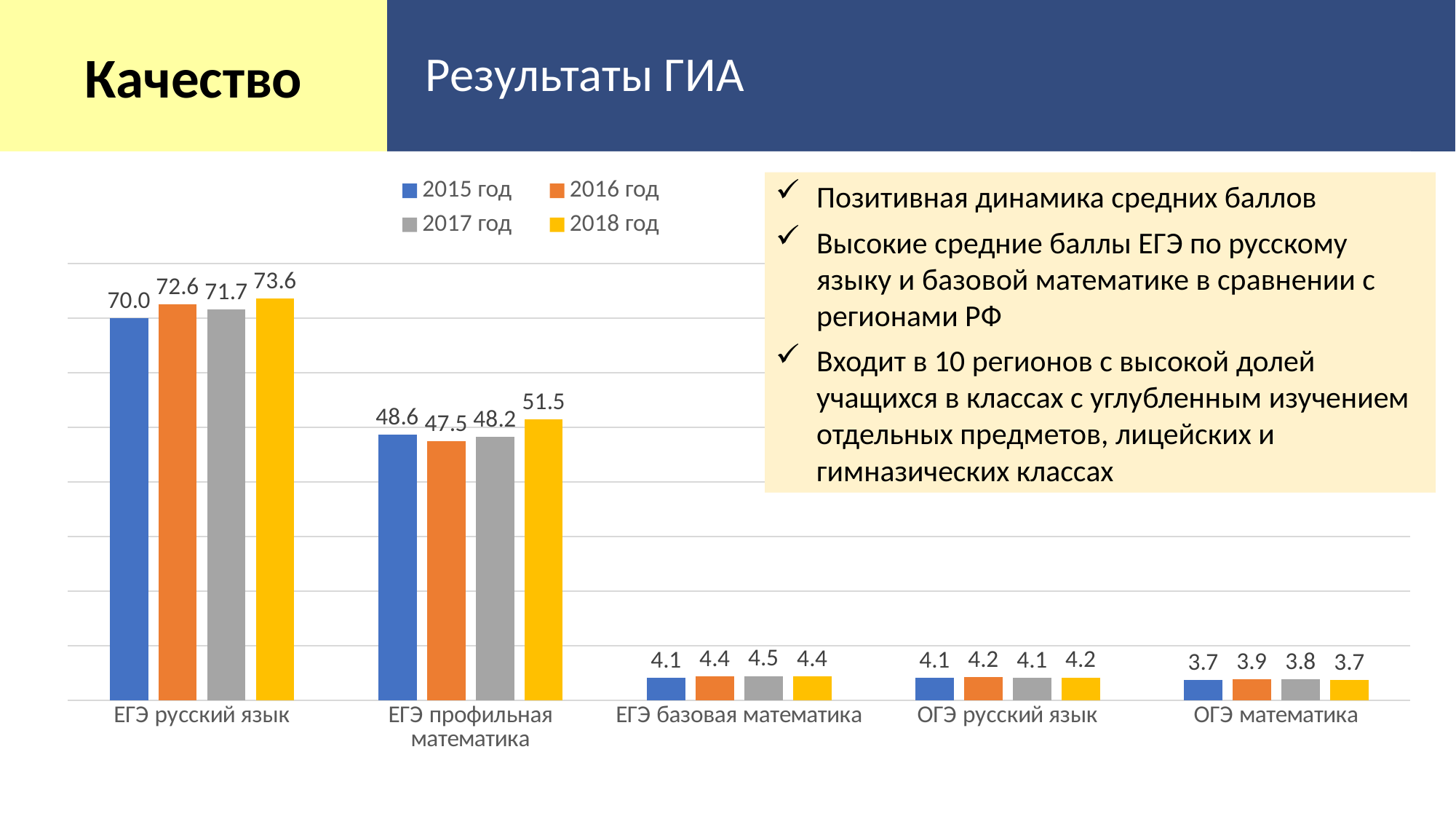
What is the difference between the 2018 год and 2015 год values for ЕГЭ русский язык? 3.6 What is the value for ЕГЭ базовая математика in 2015 год? 4.1 Which is larger for ЕГЭ профильная математика: the 2015 год value or the 2016 год value? 2015 год What is the difference between the 2018 год and 2017 год values for ЕГЭ профильная математика? 3.3 Which year has the highest value for ЕГЭ профильная математика? 2018 год How many series does the legend list? 4 Which year has the lowest value for ЕГЭ русский язык? 2015 год What kind of chart is shown on the slide? bar chart How many categories are shown on the x axis? 5 What is the value for ЕГЭ русский язык in 2018 год? 73.6 What is the value for ОГЭ математика in 2017 год? 3.8 What is the value for ЕГЭ профильная математика in 2016 год? 47.5